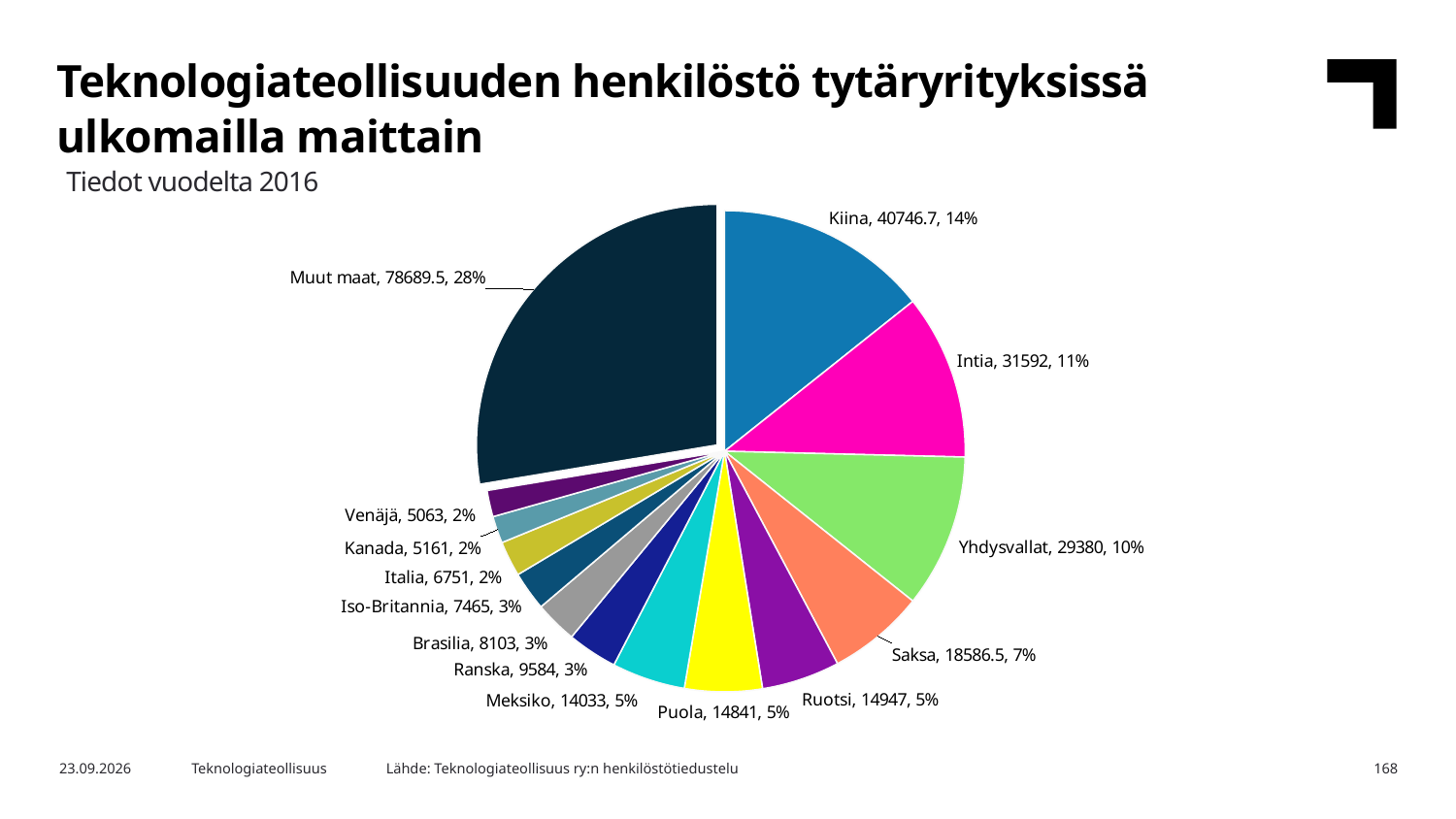
What share of the pie does Intia represent? 11% Which slice is the smallest? Venäjä How many slices does the pie chart have? 14 What is the value for Kiina? 40746.7 What is the value for Saksa? 18586.5 What is the value for Meksiko? 14033 What is the difference between the values for Ruotsi and Puola? 106 Which slice is the largest? Muut maat Which is larger, the value for Yhdysvallat or the value for Intia? Intia What share of the pie does Muut maat represent? 28% What type of chart is shown on the slide? pie chart What year do the data on the slide come from? 2016